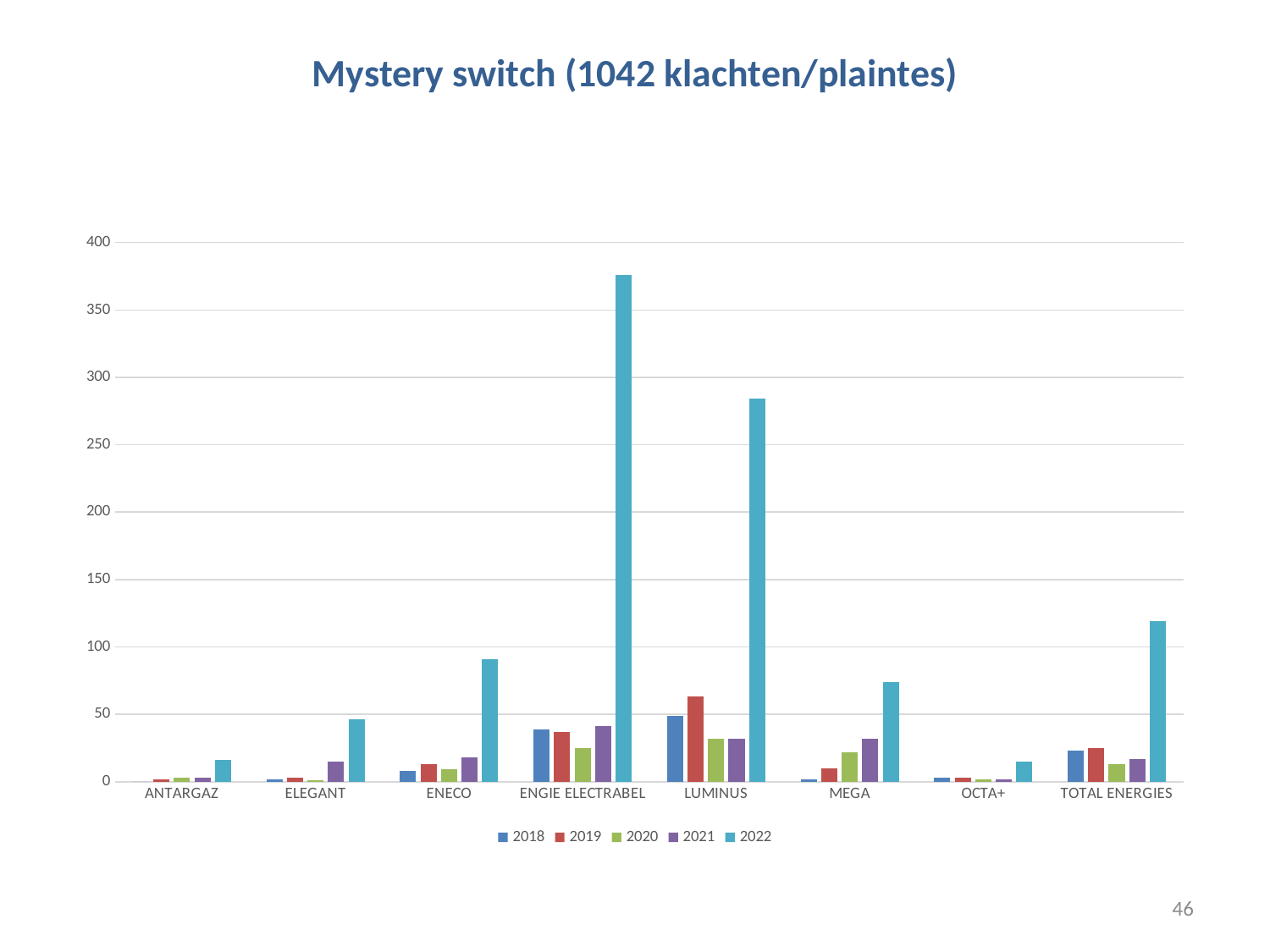
How many series does the legend list? 5 For TOTAL ENERGIES, which year has the highest bar? 2022 What kind of chart is shown on the slide? bar chart Is the 2022 value for TOTAL ENERGIES greater or less than 100? greater Is the 2022 value for LUMINUS greater or less than 300? less Which supplier has the highest bar for 2019? LUMINUS What is the title of the chart? Mystery switch (1042 klachten/plaintes) Is the 2022 value for ENGIE ELECTRABEL greater or less than 350? greater Which supplier has the highest bar for 2022? ENGIE ELECTRABEL How many suppliers (categories) are shown on the x axis? 8 Which is larger, the 2022 value for ENECO or the 2022 value for MEGA? ENECO